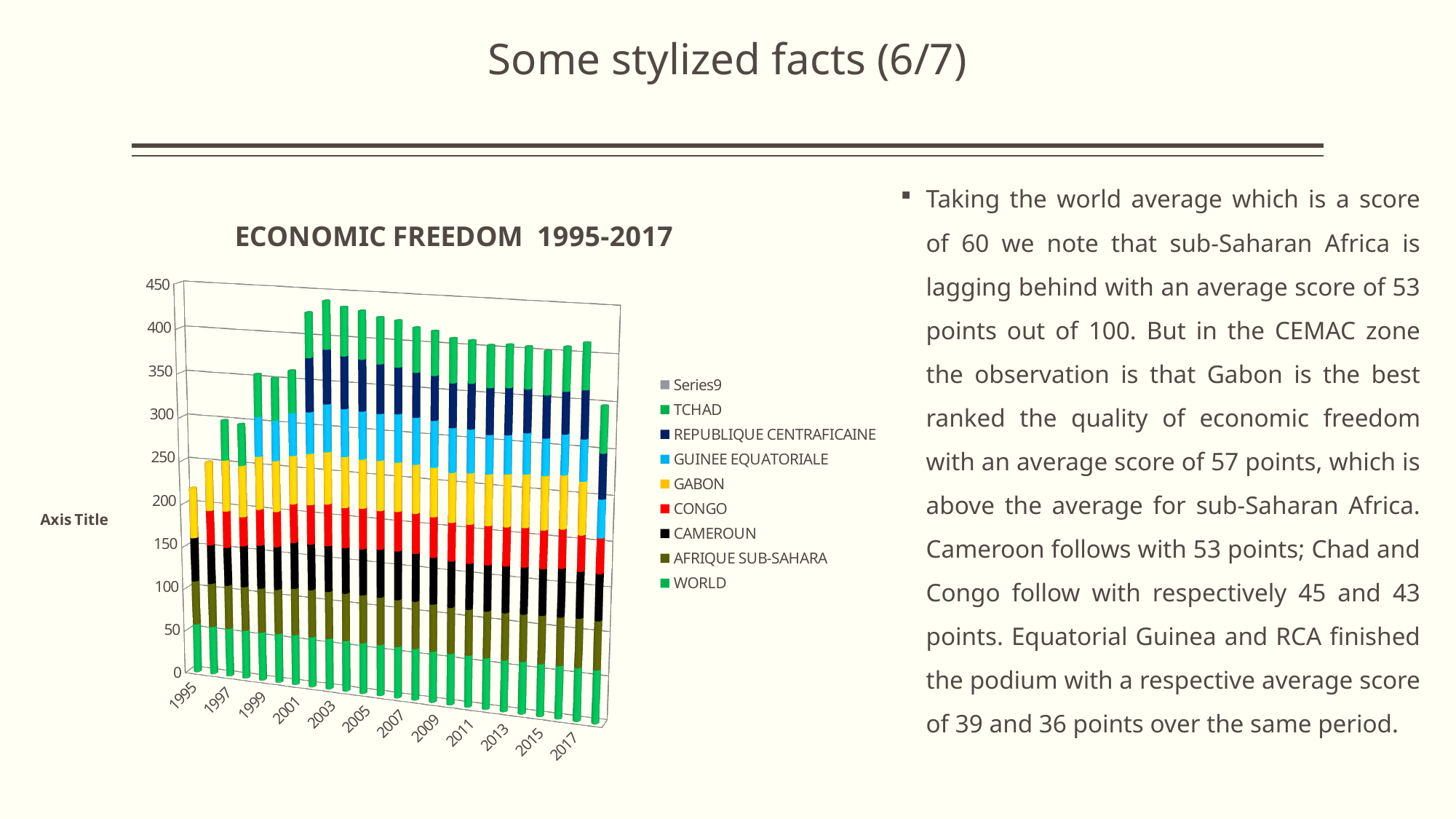
What is the label shown on the vertical axis of the chart? Axis Title Which year has a larger stacked bar total, 1995 or 2003? 2003 What is the title of the chart? ECONOMIC FREEDOM 1995-2017 Do the stacked bar totals rise or fall from 2003 to 2016? fall Is the stacked bar total for 2010 greater or less than 350? greater How many series does the chart legend list? 9 What type of chart is shown on the slide? Stacked bar chart Is the stacked bar total for 2003 greater or less than 400? greater How many years (bars) are plotted in the chart? 24 Is the stacked bar total for 1995 greater or less than 250? less Which year has the lowest stacked bar total in the chart? 1995 Which year has the highest stacked bar total in the chart? 2003